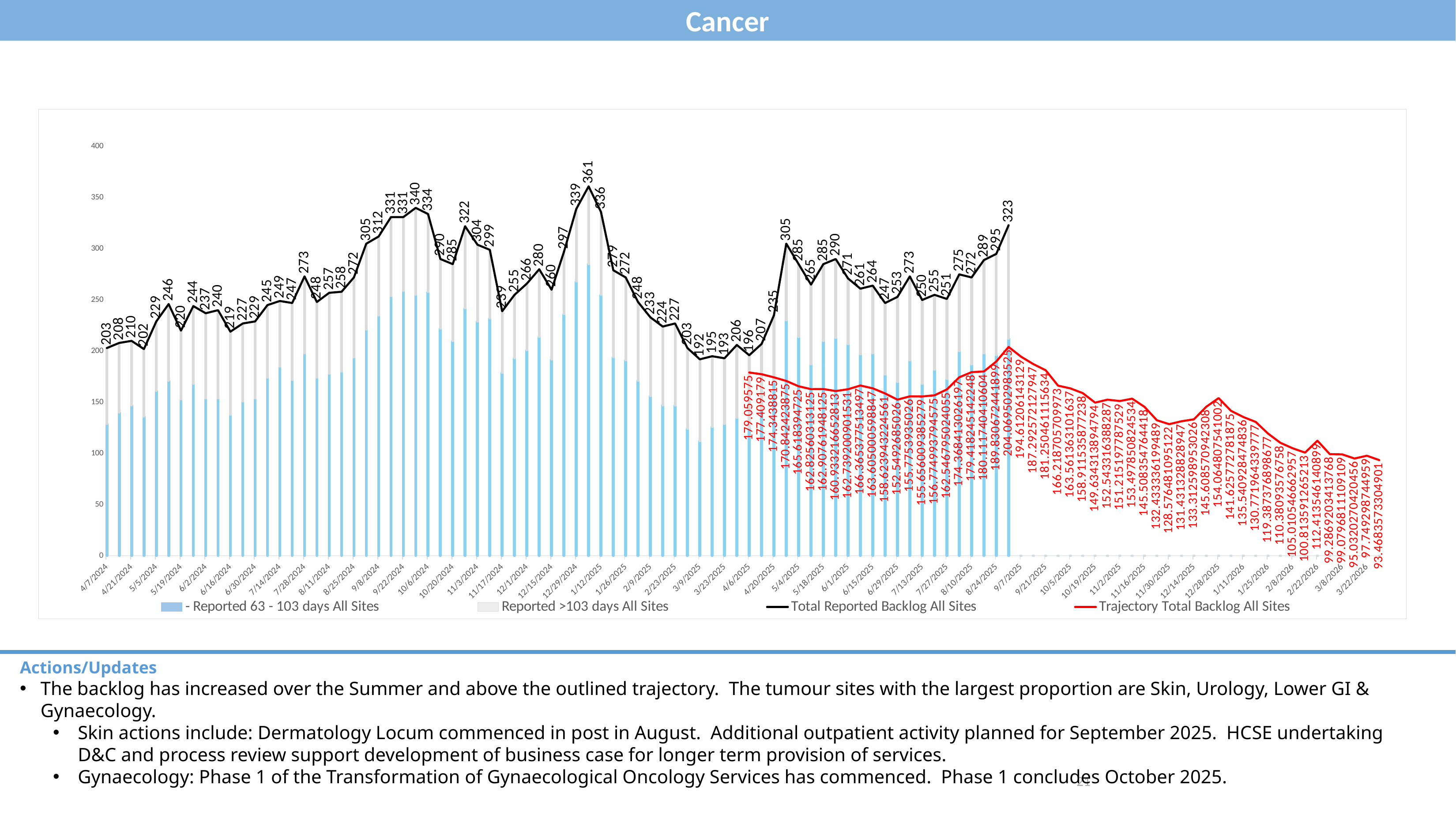
Which series is drawn as the red line? Trajectory Total Backlog All Sites Does the Trajectory Total Backlog All Sites line rise or fall from 9/7/2025 to 3/22/2026? Fall What kind of chart is shown on the slide? Combination bar and line chart What is the lowest value shown on the Total Reported Backlog All Sites line? 192 What is the difference between the highest (361) and lowest (192) values on the Total Reported Backlog All Sites line? 169 What is the highest value shown on the Total Reported Backlog All Sites line? 361 What is the Total Reported Backlog All Sites value at 4/7/2024, the first point on the chart? 203 How many series does the legend list? 4